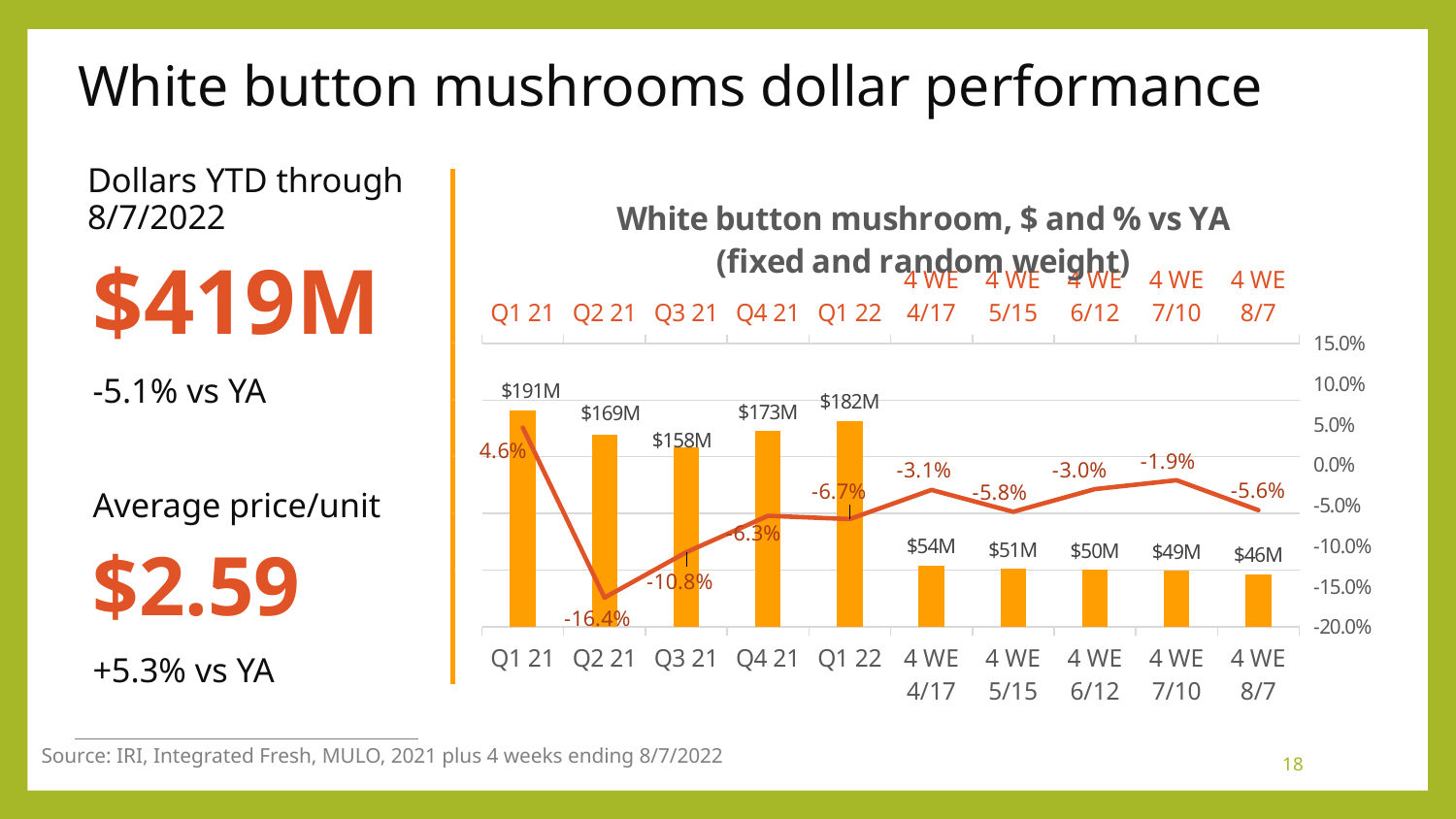
What kind of chart is used to show the dollar values? bar chart What is the title of the chart? White button mushroom, $ and % vs YA (fixed and random weight) How many periods are shown on the x axis? 10 Which period has the highest dollar value? Q1 21 What is the dollar value shown for the 4 WE 8/7 period? $46M What is the % vs YA value shown for the 4 WE 7/10 period? -1.9% What is the difference in dollars between Q1 22 and Q4 21? $9M Which period has the lowest % vs YA value? Q2 21 What is the % vs YA value shown for Q2 21? -16.4% What is the dollar value shown for Q1 21? $191M Which has the larger dollar value, Q3 21 or Q4 21? Q4 21 Do the dollar values of the 4 WE periods rise or fall from 4/17 to 8/7? fall